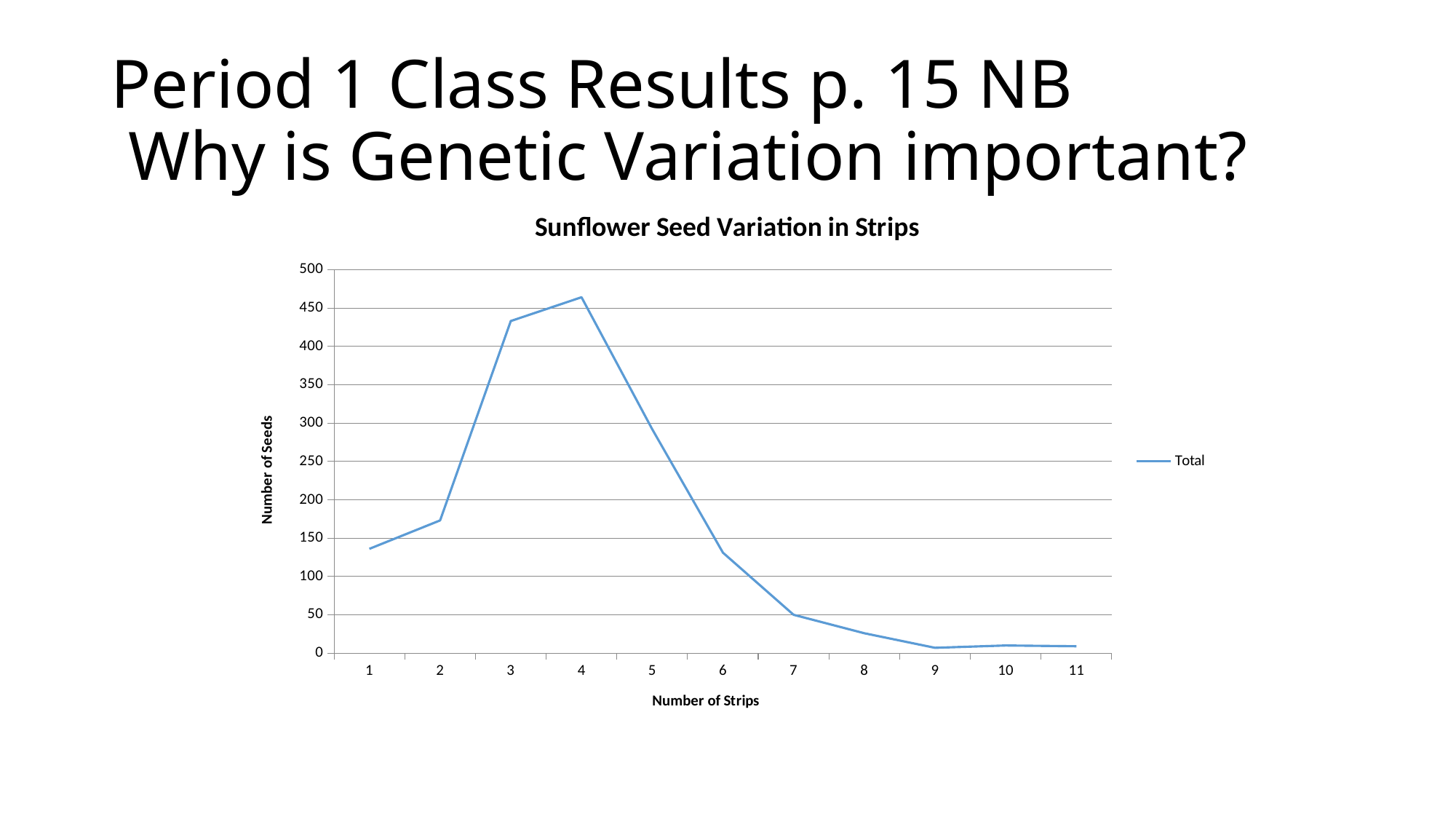
How many strip categories are plotted along the x axis? 11 What kind of chart is shown on the slide? line chart Is the value for 1 strip greater or less than 150? less What is the title of the chart? Sunflower Seed Variation in Strips Which has a larger number of seeds, 3 strips or 6 strips? 3 strips Is the value for 7 strips greater or less than 100? less Is the value for 3 strips greater or less than 400? greater What is the name of the series shown in the legend? Total How many series does the legend list? 1 Do the values rise or fall from 4 strips to 9 strips? fall Which number of strips has the highest number of seeds? 4